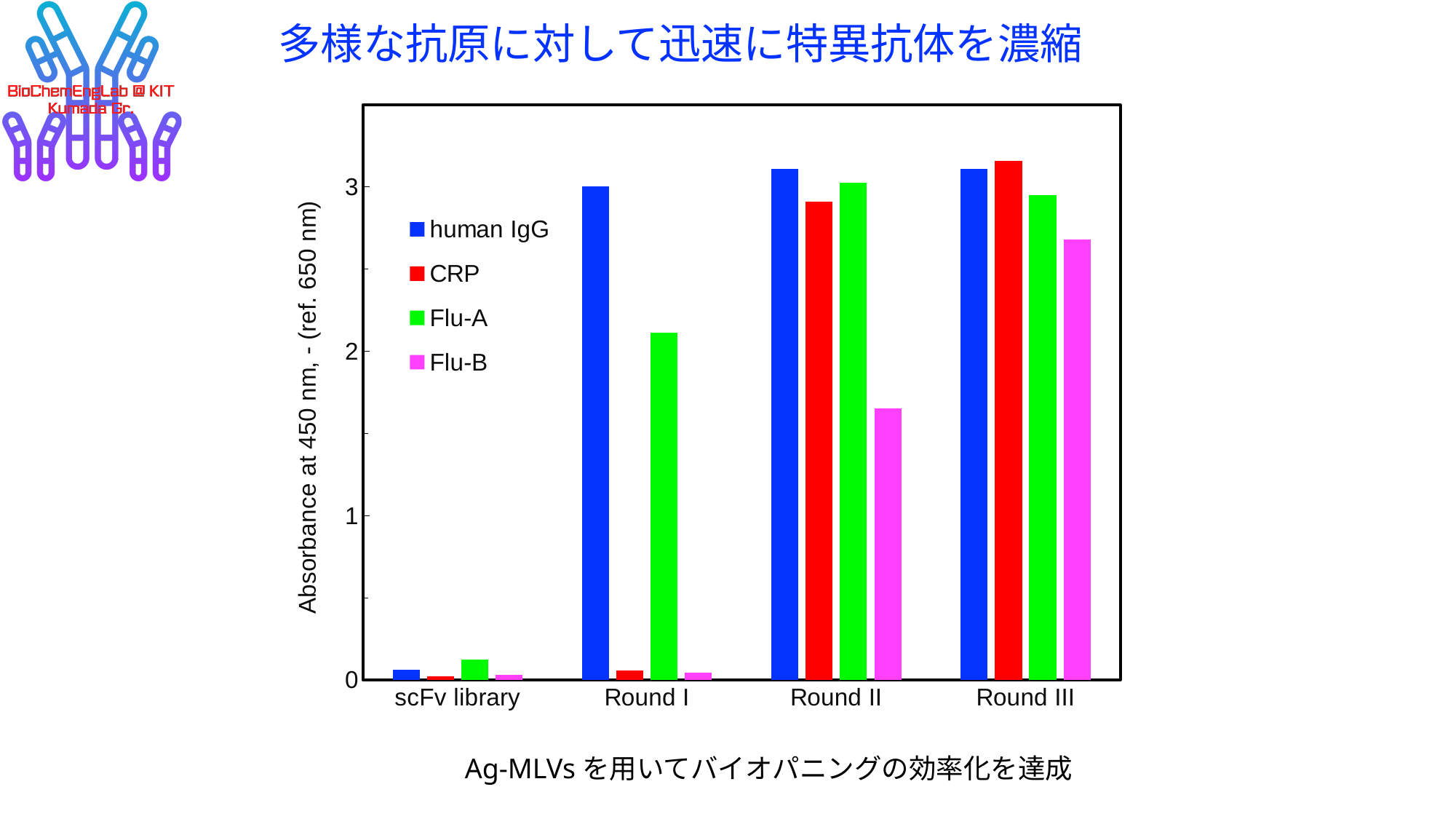
How many series does the legend list? 4 Is the Flu-B value for Round III greater or less than 2? greater What kind of chart is shown on the slide? bar chart Which series has the highest value in Round I? human IgG Which series has the lowest value in Round II? Flu-B What colour represents CRP in the legend? red Is the Flu-B value for Round II greater or less than 2? less Is the Flu-A value for Round I greater or less than 2? greater How many categories are shown on the x axis? 4 In Round II, which is larger, the Flu-A value or the Flu-B value? Flu-A Does the Flu-B value rise or fall from scFv library to Round III? rise